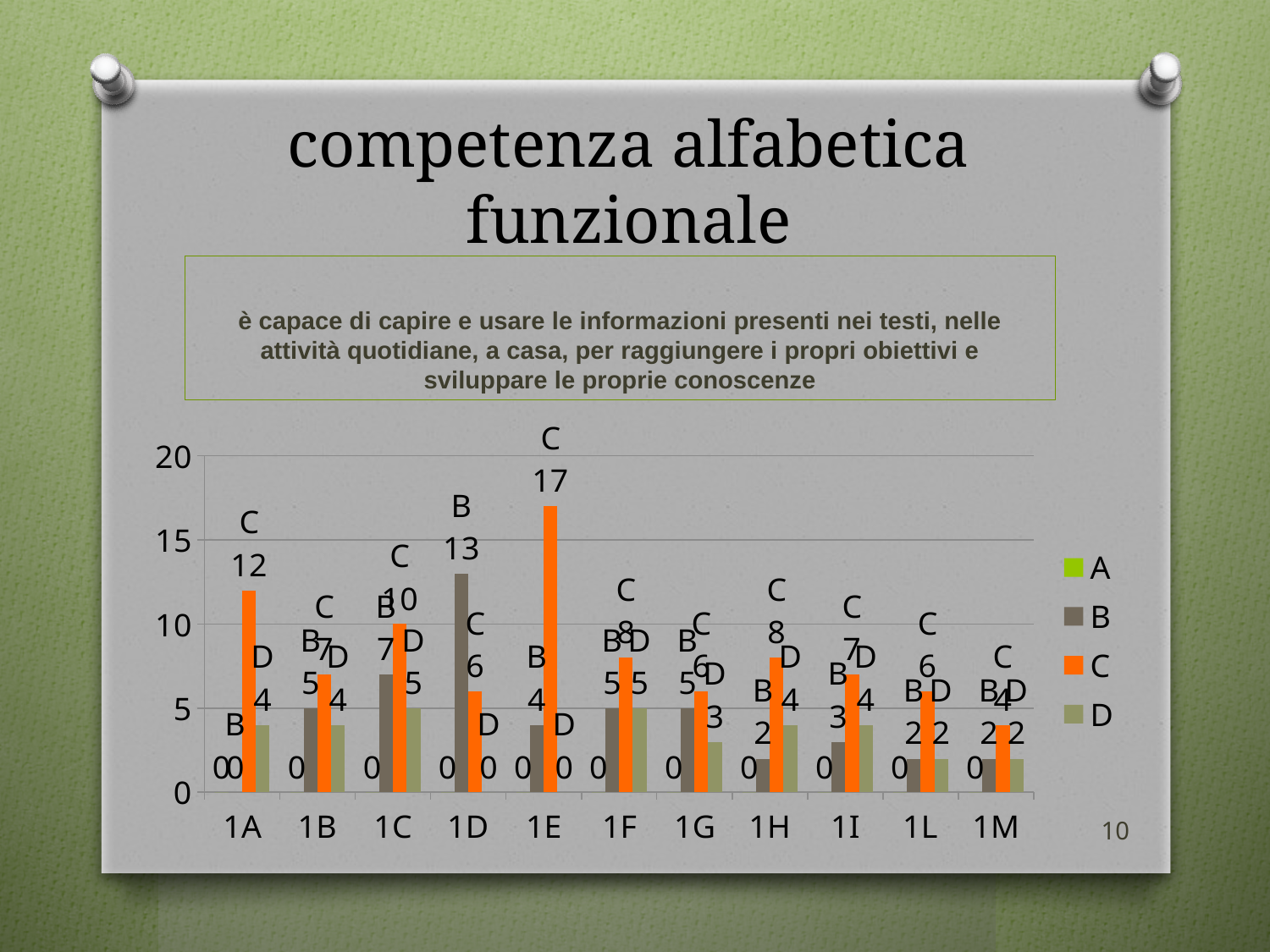
Which category has the highest value for series C? 1E Which is larger for category 1C: the value of series B or series C? C What is the difference between the C value and the B value for category 1E? 13 Which category has the highest value for series B? 1D What kind of chart is shown on the slide? bar chart What is the value of series A for category 1H? 0 What is the value of series D for category 1C? 5 What is the value of series C for category 1E? 17 How many series does the legend list? 4 What is the value of series B for category 1D? 13 How many categories are shown on the x axis? 11 What is the value of series C for category 1A? 12